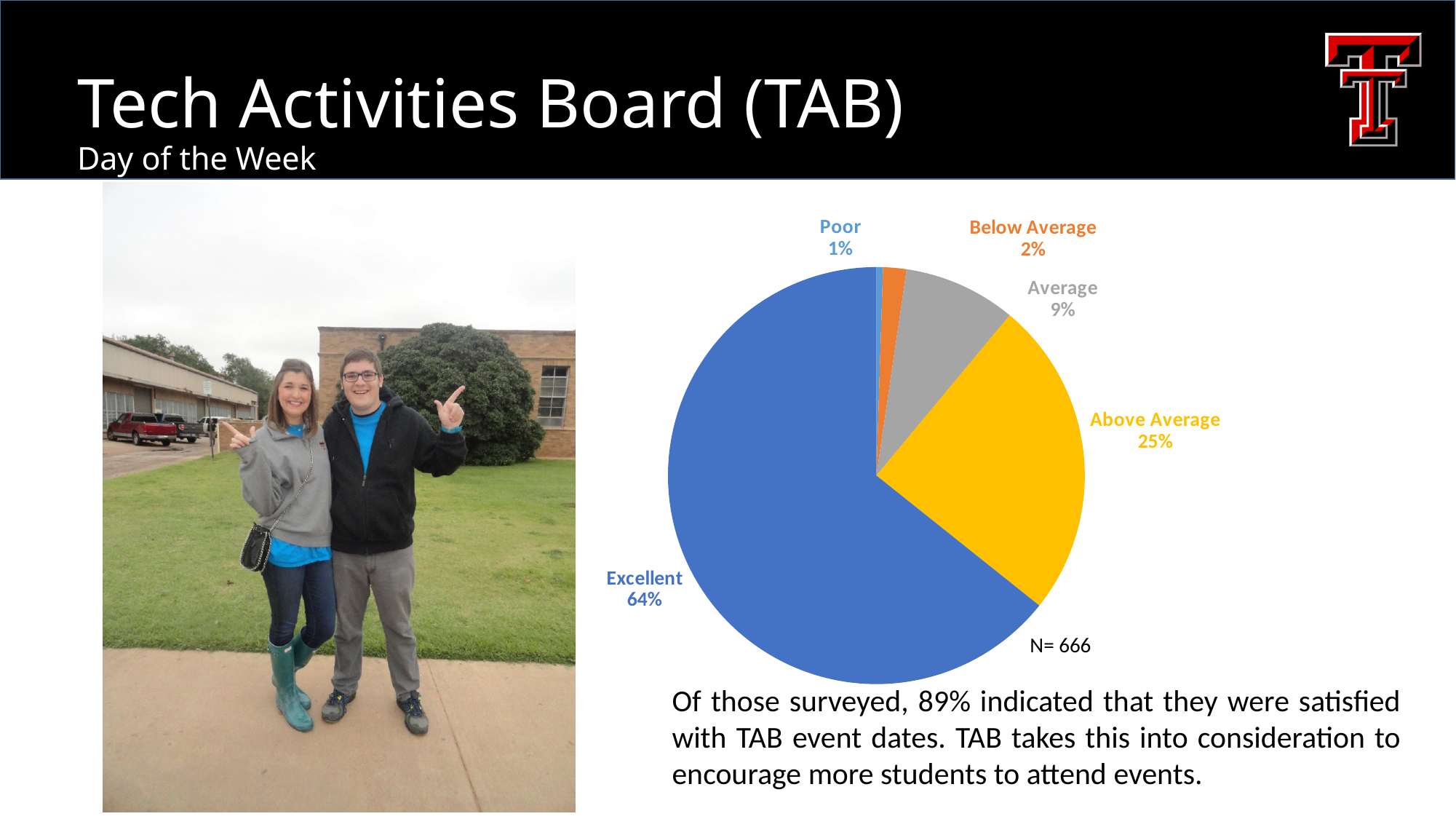
What percentage of respondents rated the day of the week as Poor? 1% What is the difference in percentage points between the Excellent and Above Average slices? 39 What percentage of respondents rated the day of the week as Average? 9% What percentage of respondents rated the day of the week as Excellent? 64% How many categories are shown in the pie chart? 5 What percentage of respondents rated the day of the week as Below Average? 2% What is the sample size (N) shown next to the pie chart? N= 666 What type of chart is shown on the slide? pie chart Which category has the largest share of the pie? Excellent What percentage of respondents rated the day of the week as Above Average? 25% Which slice is larger, Average or Below Average? Average Which category has the smallest share of the pie? Poor